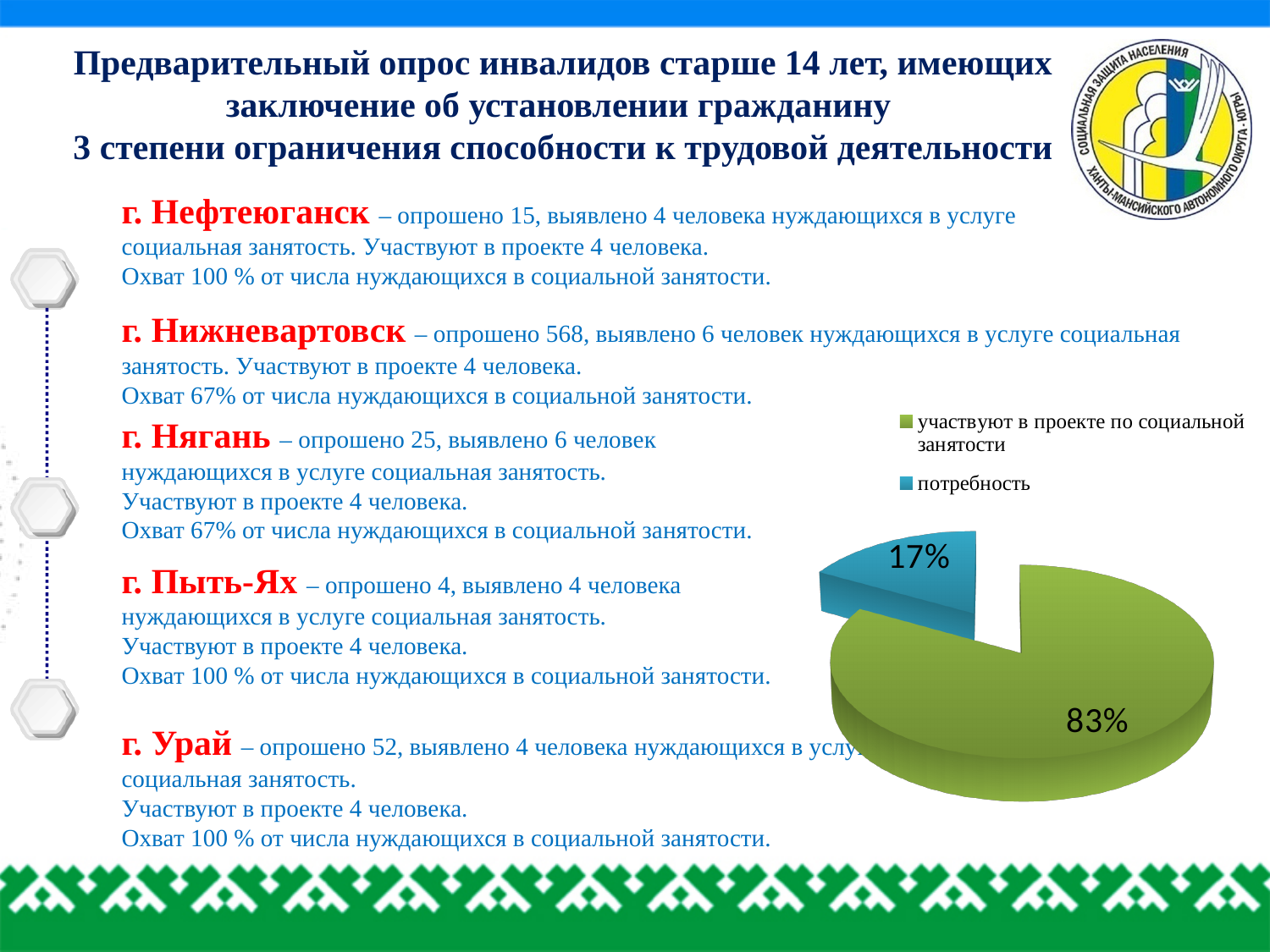
Which is larger in the pie chart: "потребность" or "участвуют в проекте по социальной занятости"? участвуют в проекте по социальной занятости What share of the pie does the slice "потребность" take? 17% What colour is the "потребность" slice in the pie chart? blue How many slices does the pie chart have? 2 Which slice of the pie chart is the largest? участвуют в проекте по социальной занятости What colour is the "участвуют в проекте по социальной занятости" slice in the pie chart? green Is the share of the "потребность" slice greater or less than 50%? less What is the difference in percentage points between the "участвуют в проекте по социальной занятости" slice and the "потребность" slice? 66 What kind of chart is shown on the slide? pie chart What share of the pie does the slice "участвуют в проекте по социальной занятости" take? 83% Which slice of the pie chart is the smallest? потребность How many entries does the legend of the pie chart list? 2